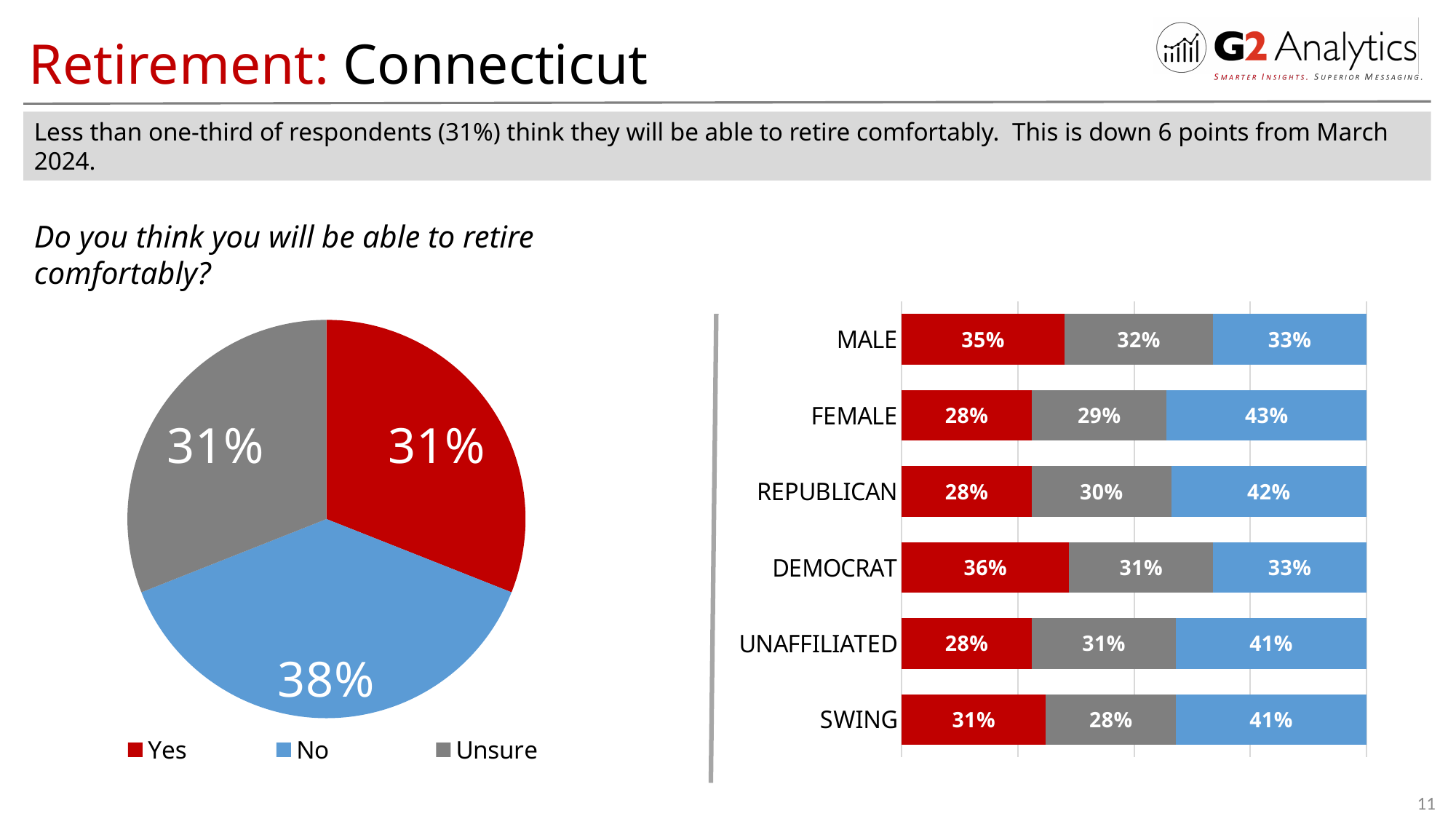
In the pie chart, which response has the largest slice? No In the bar chart on the right, what is the difference between the blue segment values for FEMALE and MALE? 10% In the bar chart on the right, what is the value of the blue segment for FEMALE? 43% What kind of chart is on the right side of the slide? Bar chart In the bar chart on the right, is the red segment for MALE or for FEMALE larger? MALE How many slices does the pie chart have? 3 In the bar chart on the right, what is the value of the red segment for DEMOCRAT? 36% In the pie chart, what share of respondents answered Yes? 31% What kind of chart is on the left side of the slide? Pie chart In the bar chart on the right, which category has the highest red segment value? DEMOCRAT In the pie chart, what share of respondents answered No? 38% How many categories are shown in the bar chart on the right? 6